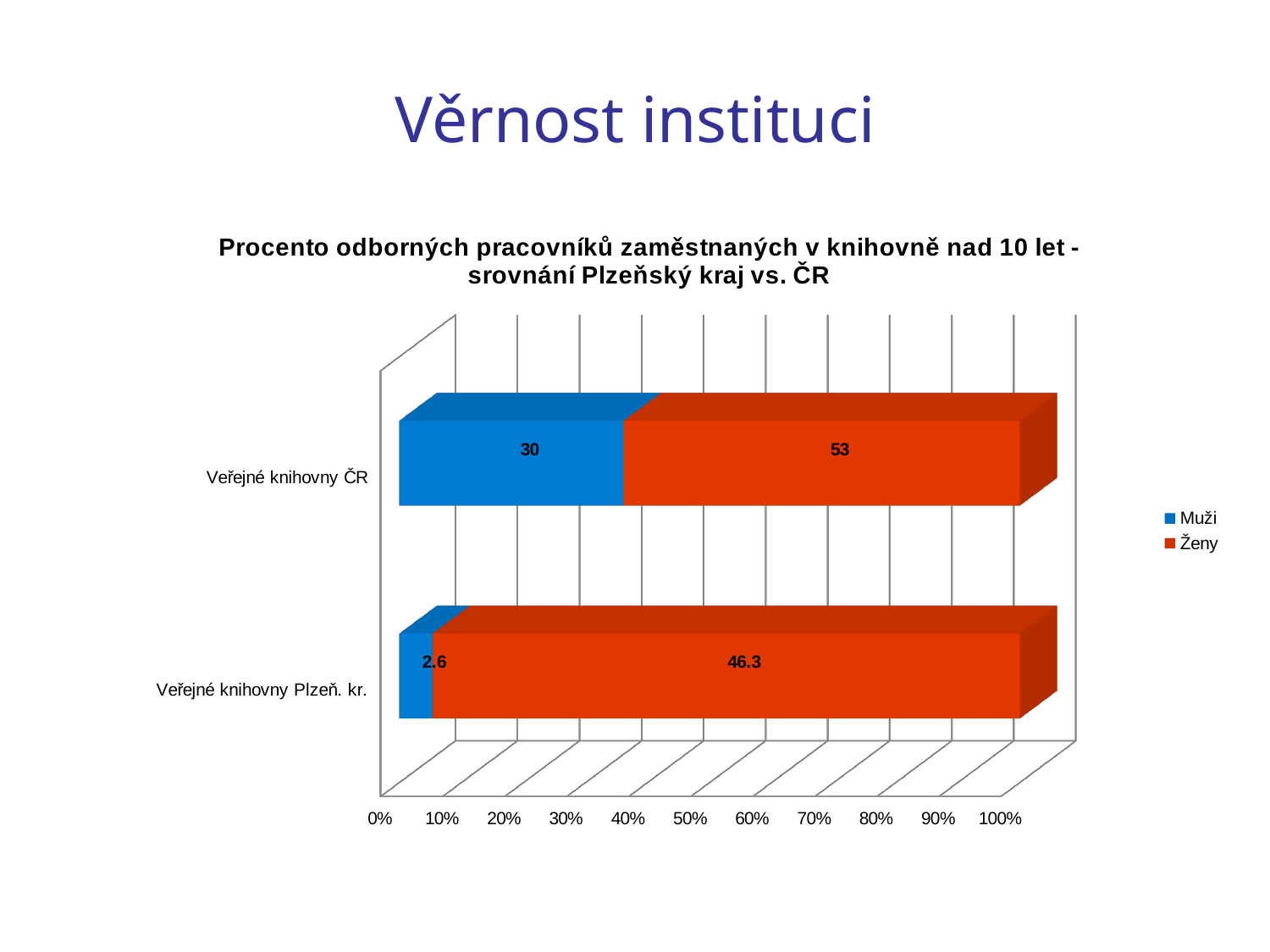
What is the value for Muži in the Veřejné knihovny ČR bar? 30 Which category has the lower value for Ženy? Veřejné knihovny Plzeň. kr. What kind of chart is shown on the slide? Stacked bar chart What is the value for Ženy in the Veřejné knihovny Plzeň. kr. bar? 46.3 How many series does the legend list? 2 What is the difference between the Ženy values for Veřejné knihovny ČR and Veřejné knihovny Plzeň. kr.? 6.7 What is the value for Muži in the Veřejné knihovny Plzeň. kr. bar? 2.6 What is the difference between the Muži values for Veřejné knihovny ČR and Veřejné knihovny Plzeň. kr.? 27.4 How many categories are shown on the chart? 2 Which category has the higher value for Muži, Veřejné knihovny ČR or Veřejné knihovny Plzeň. kr.? Veřejné knihovny ČR What is the sum of the two labelled values in the Veřejné knihovny ČR bar? 83 What is the value for Ženy in the Veřejné knihovny ČR bar? 53